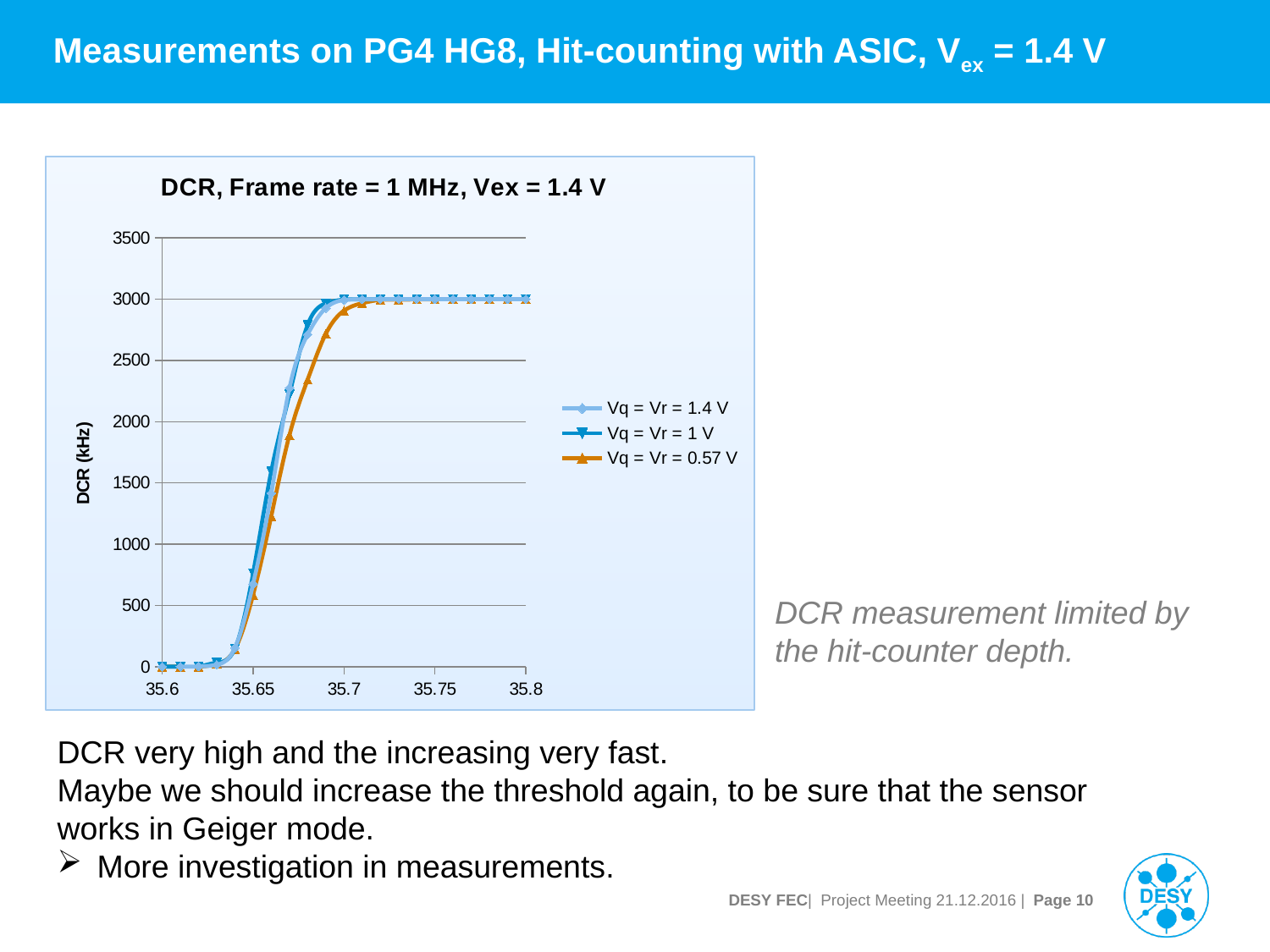
Is the value for Vq = Vr = 1 V at x = 35.7 greater or less than 2500? greater What is the title of the chart? DCR, Frame rate = 1 MHz, Vex = 1.4 V Is the value for Vq = Vr = 0.57 V at x = 35.65 greater or less than 500? greater Is the value for Vq = Vr = 1.4 V at x = 35.8 greater or less than 2500? greater Do the DCR values rise or fall as the x-axis value increases from 35.6 to 35.7? rise How many series does the legend of the chart list? 3 At x = 35.65, which series has the higher DCR: Vq = Vr = 1.4 V or Vq = Vr = 0.57 V? Vq = Vr = 1.4 V What is the label of the y axis of the chart? DCR (kHz) What kind of chart is shown on the slide? line chart What is the highest value shown on the y axis of the chart? 3500 At x = 35.65, which series has the lowest DCR? Vq = Vr = 0.57 V